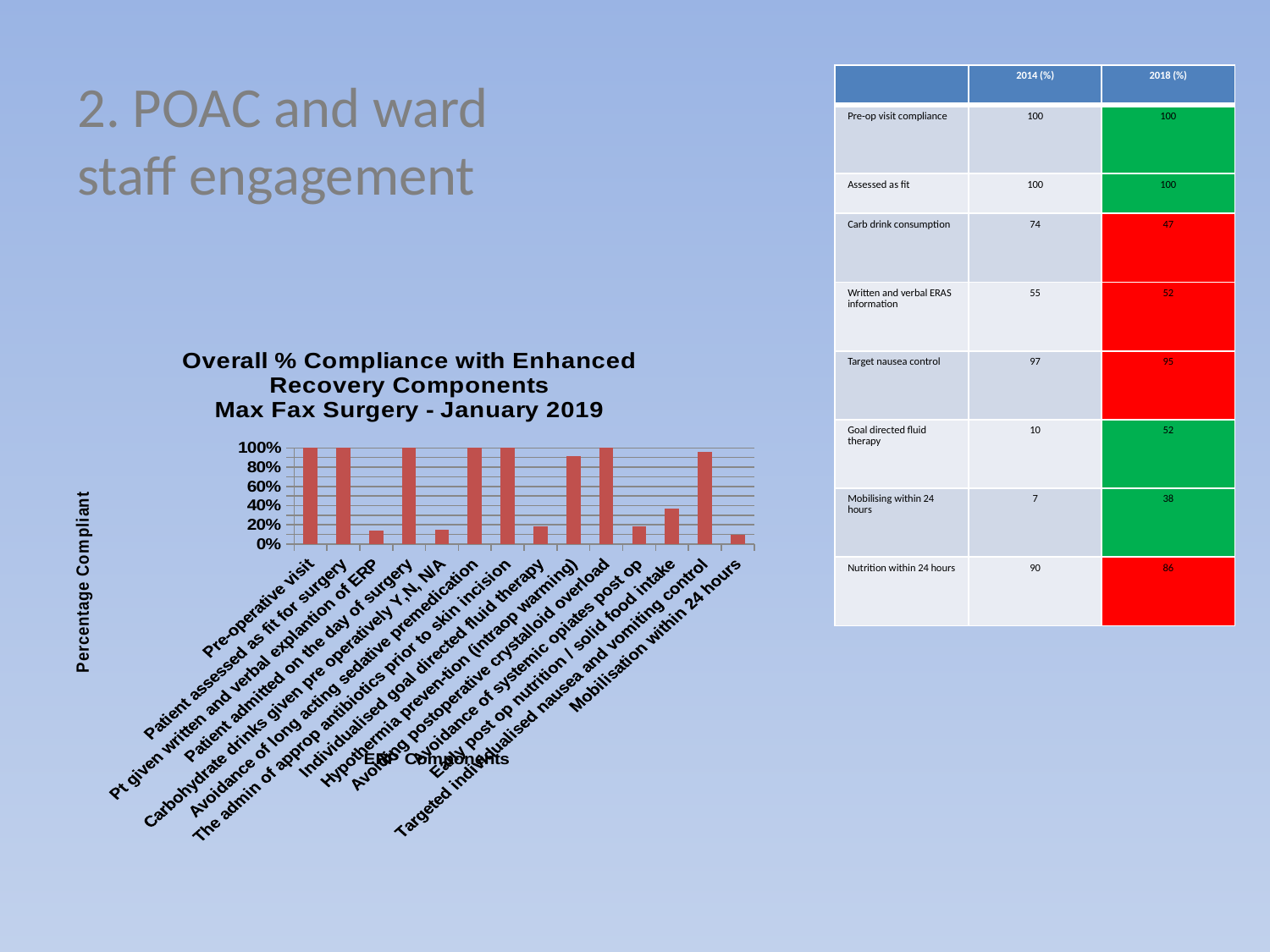
Is the value for Early post op nutrition / solid food intake greater or less than 60%? less What is the percentage compliant for Pre-operative visit? 100% Is the value for Hypothermia preven-tion (intraop warming) greater or less than 80%? greater Is the value for Mobilisation within 24 hours greater or less than 20%? less Which is larger, the value for Targeted individualised nausea and vomiting control or the value for Individualised goal directed fluid therapy? Targeted individualised nausea and vomiting control What is the percentage compliant for Patient admitted on the day of surgery? 100% How many ERP components (categories) are plotted in the chart? 14 What is the label of the vertical axis of the chart? Percentage Compliant What kind of chart is shown on the slide? bar chart Which is larger, the value for Early post op nutrition / solid food intake or the value for Avoidance of systemic opiates post op? Early post op nutrition / solid food intake What is the title of the chart? Overall % Compliance with Enhanced Recovery Components Max Fax Surgery - January 2019